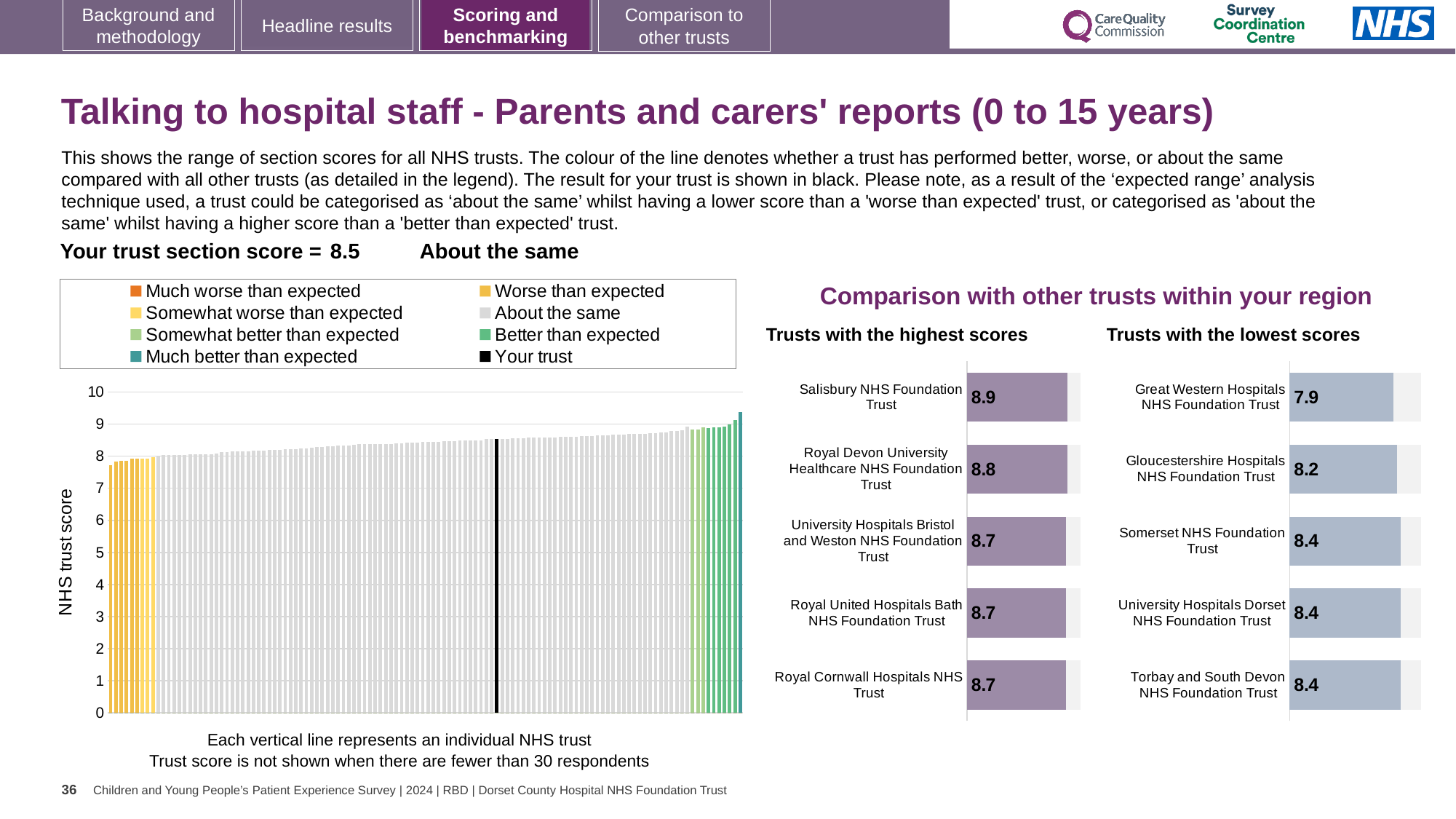
How many trusts are listed in the 'Trusts with the highest scores' chart? 5 What kind of chart is the 'NHS trust score' chart on the left of the slide? Bar chart In the 'NHS trust score' chart on the left, is the value of the black bar (your trust) greater or less than 8? greater How many entries does the legend above the 'NHS trust score' chart list? 8 In the 'Trusts with the highest scores' chart, what is the difference between the scores of Salisbury NHS Foundation Trust and Royal Cornwall Hospitals NHS Trust? 0.2 Which is larger: the score for Royal Devon University Healthcare NHS Foundation Trust in the highest scores chart or the score for Somerset NHS Foundation Trust in the lowest scores chart? Royal Devon University Healthcare NHS Foundation Trust In the 'Trusts with the highest scores' chart, what is the score for Salisbury NHS Foundation Trust? 8.9 In the 'NHS trust score' chart on the left, do the bar values rise or fall from left to right? Rise In the 'Trusts with the lowest scores' chart, what is the difference between the scores of Gloucestershire Hospitals NHS Foundation Trust and Great Western Hospitals NHS Foundation Trust? 0.3 In the 'Trusts with the lowest scores' chart, which trust has the lowest score? Great Western Hospitals NHS Foundation Trust In the 'Trusts with the highest scores' chart, which trust has the highest score? Salisbury NHS Foundation Trust In the 'Trusts with the lowest scores' chart, what is the score for Gloucestershire Hospitals NHS Foundation Trust? 8.2